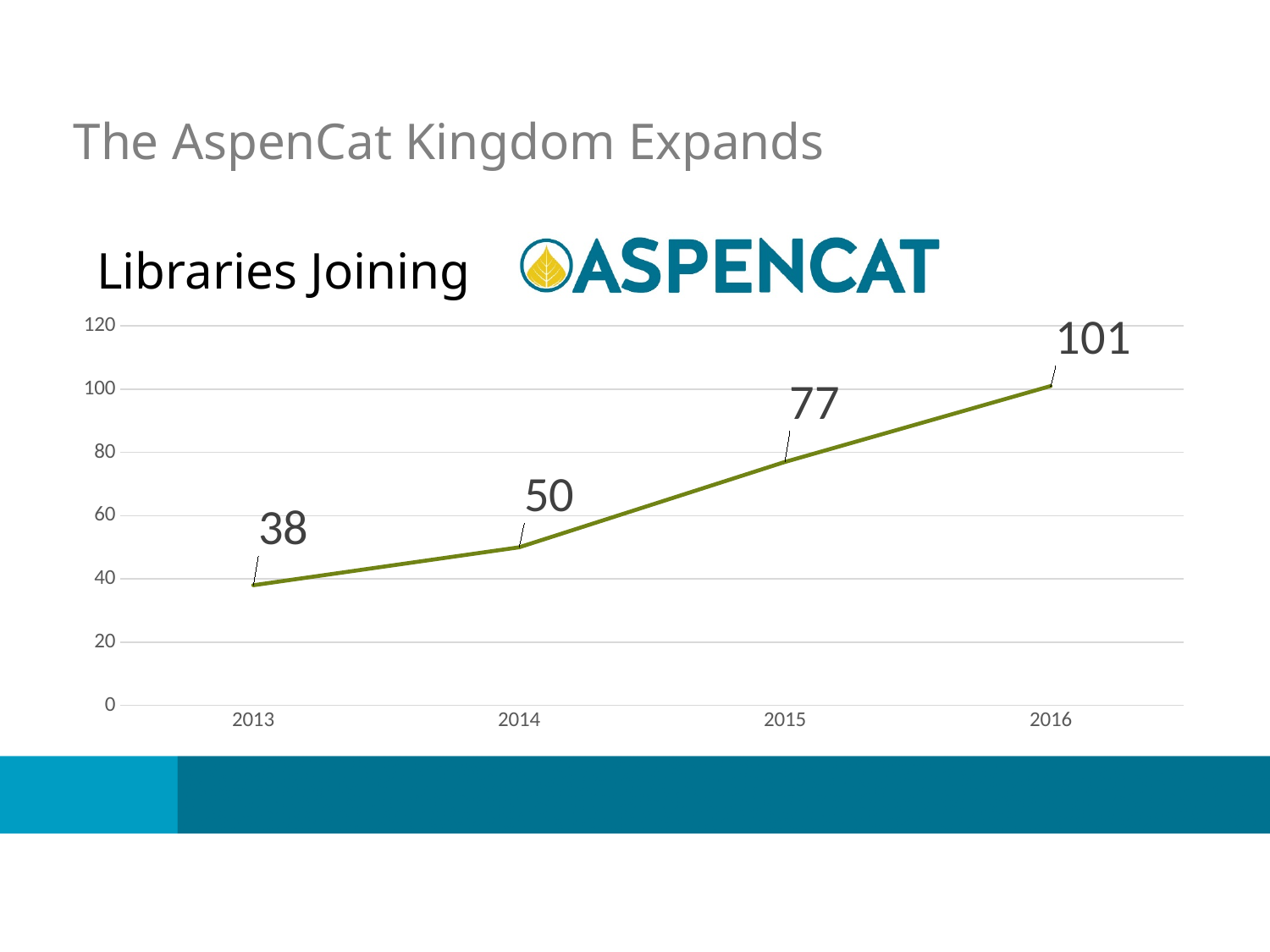
What is the value for 2013? 38 Which year has the lowest value? 2013 What is the difference between the values for 2014 and 2013? 12 What is the value for 2015? 77 What is the difference between the values for 2016 and 2015? 24 How many years are plotted on the chart? 4 What kind of chart is shown? line chart Do the values rise or fall from 2013 to 2016? rise What is the value for 2014? 50 Which year has the highest value? 2016 What is the value for 2016? 101 Which is larger, the value for 2015 or the value for 2014? 2015